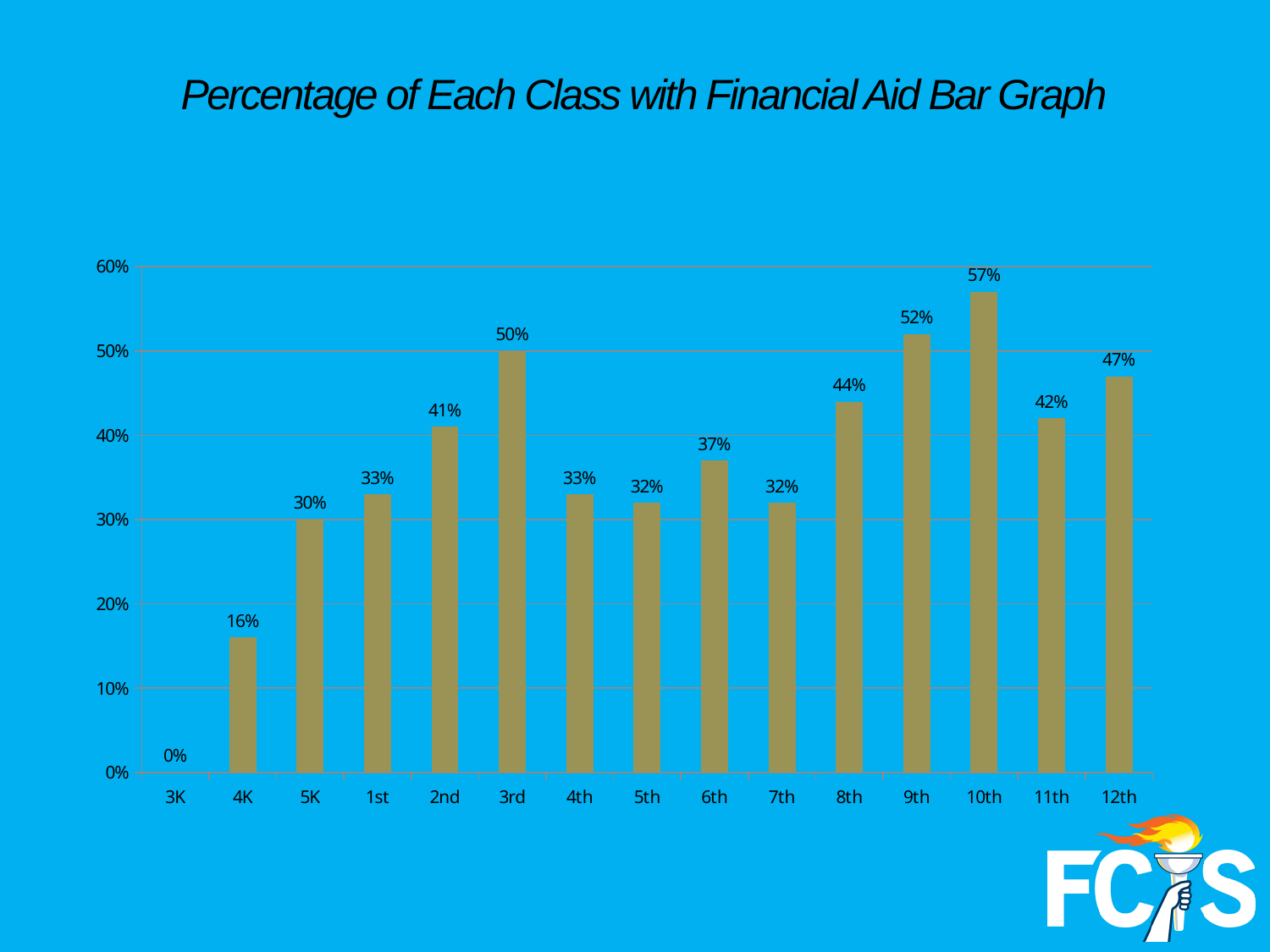
What percentage is shown for 9th grade? 52% What kind of chart is shown on the slide? bar chart Which has a higher percentage with financial aid, 8th grade or 12th grade? 12th Which class has the highest percentage with financial aid? 10th What is the title of the chart? Percentage of Each Class with Financial Aid Bar Graph How many classes are shown on the x axis? 15 What is the difference between the percentages for 10th and 11th grade? 15% Which class has the lowest percentage with financial aid? 3K What is the difference between the values for 5K and 4K? 14% What is the value shown for 4K? 16% What percentage of the 3rd grade class has financial aid? 50% Is the value for 6th grade greater or less than 40%? less